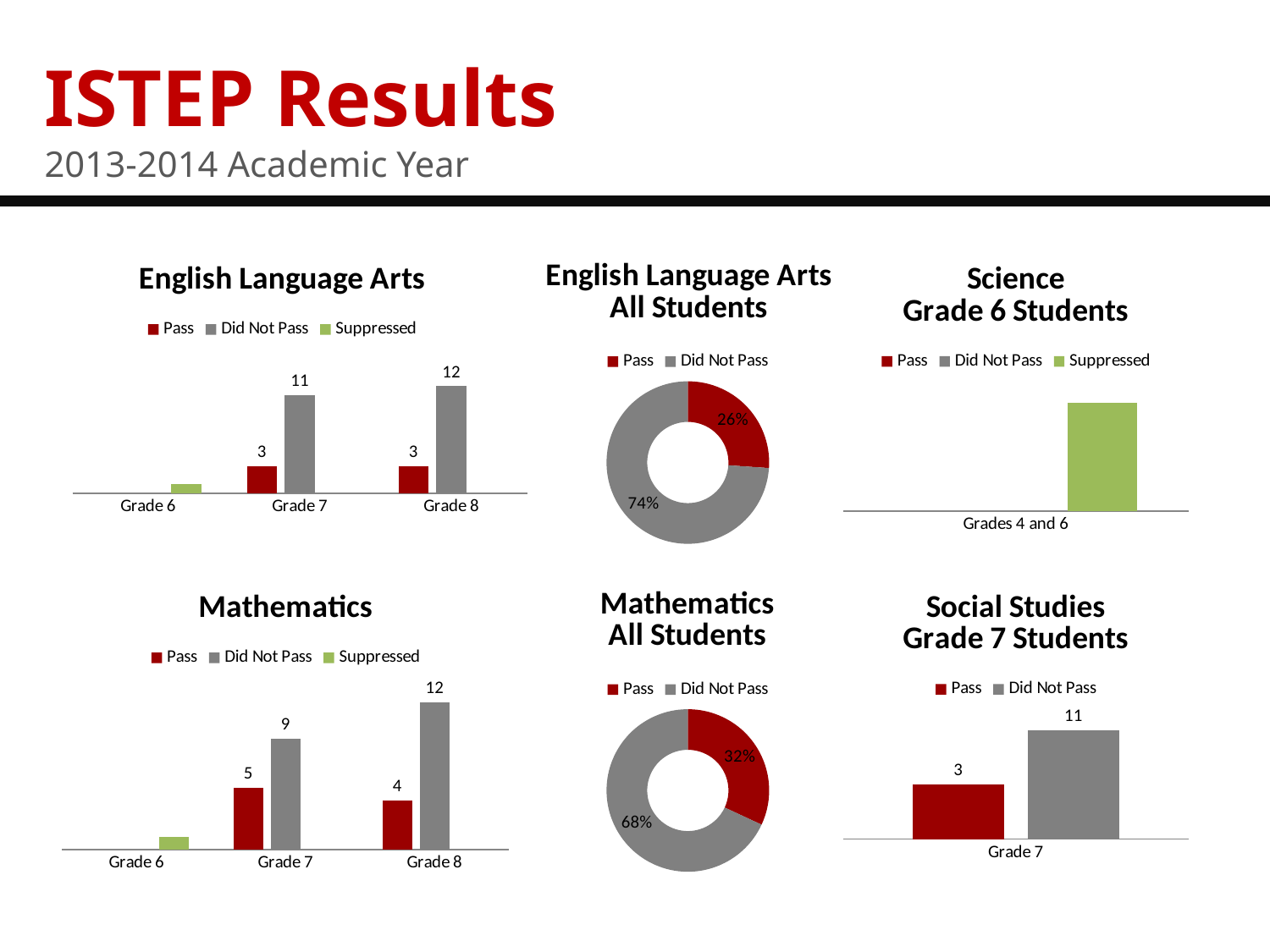
In the Mathematics bar chart, is the Pass value for Grade 7 larger or smaller than the Pass value for Grade 8? Larger In the English Language Arts bar chart, what is the Did Not Pass value for Grade 8? 12 In the English Language Arts All Students chart, what share of students did not pass? 74% How many series does the legend of the English Language Arts bar chart list? 3 In the Mathematics bar chart, which grade has the highest Did Not Pass value? Grade 8 In the Social Studies Grade 7 Students chart, what is the Did Not Pass value? 11 In the Mathematics All Students chart, what percentage of students passed? 32% In the English Language Arts bar chart, what is the difference between Did Not Pass and Pass for Grade 7? 8 In the Science Grade 6 Students chart, what is the category label on the x axis? Grades 4 and 6 In the Mathematics bar chart, what is the Did Not Pass value for Grade 7? 9 What kind of chart is the English Language Arts All Students chart? Doughnut chart In the English Language Arts bar chart, what is the Pass value for Grade 7? 3